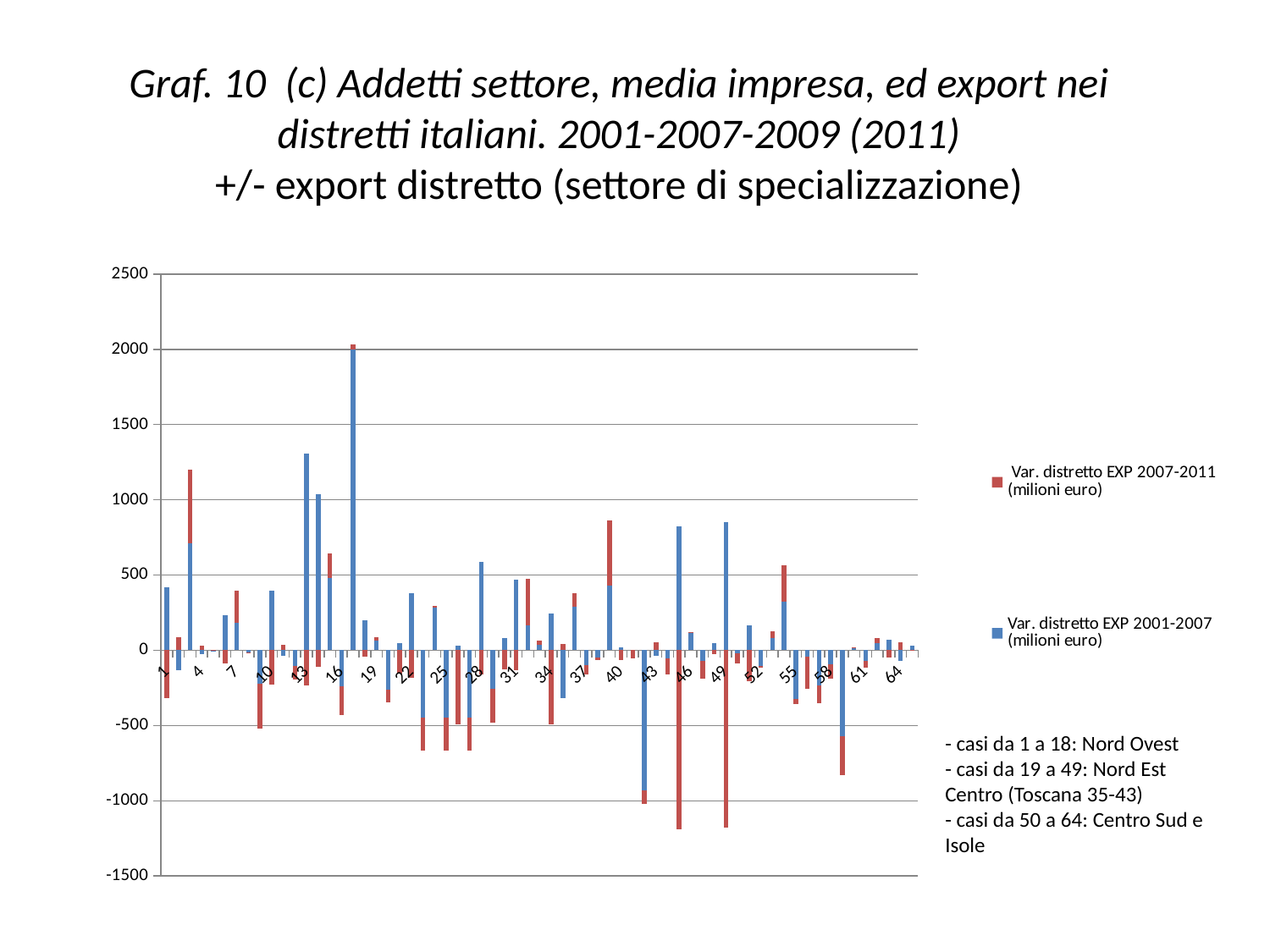
Is the value for category 13 in the Var. distretto EXP 2001-2007 series greater or less than 1000? greater Which series is shown in red in the legend? Var. distretto EXP 2007-2011 (milioni euro) What kind of chart is shown on the slide? bar chart Is the value for category 16 in the Var. distretto EXP 2001-2007 series greater or less than 1500? less Is the value for category 40 in the Var. distretto EXP 2007-2011 series greater or less than 500? less Which is larger for the Var. distretto EXP 2001-2007 series: the value for category 13 or the value for category 16? 13 How many cases (categories) are plotted along the x axis? 65 Which category has the highest value for Var. distretto EXP 2001-2007 (milioni euro)? 17 According to the note on the slide, which cases (casi) correspond to Nord Ovest? da 1 a 18 How many series does the legend list? 2